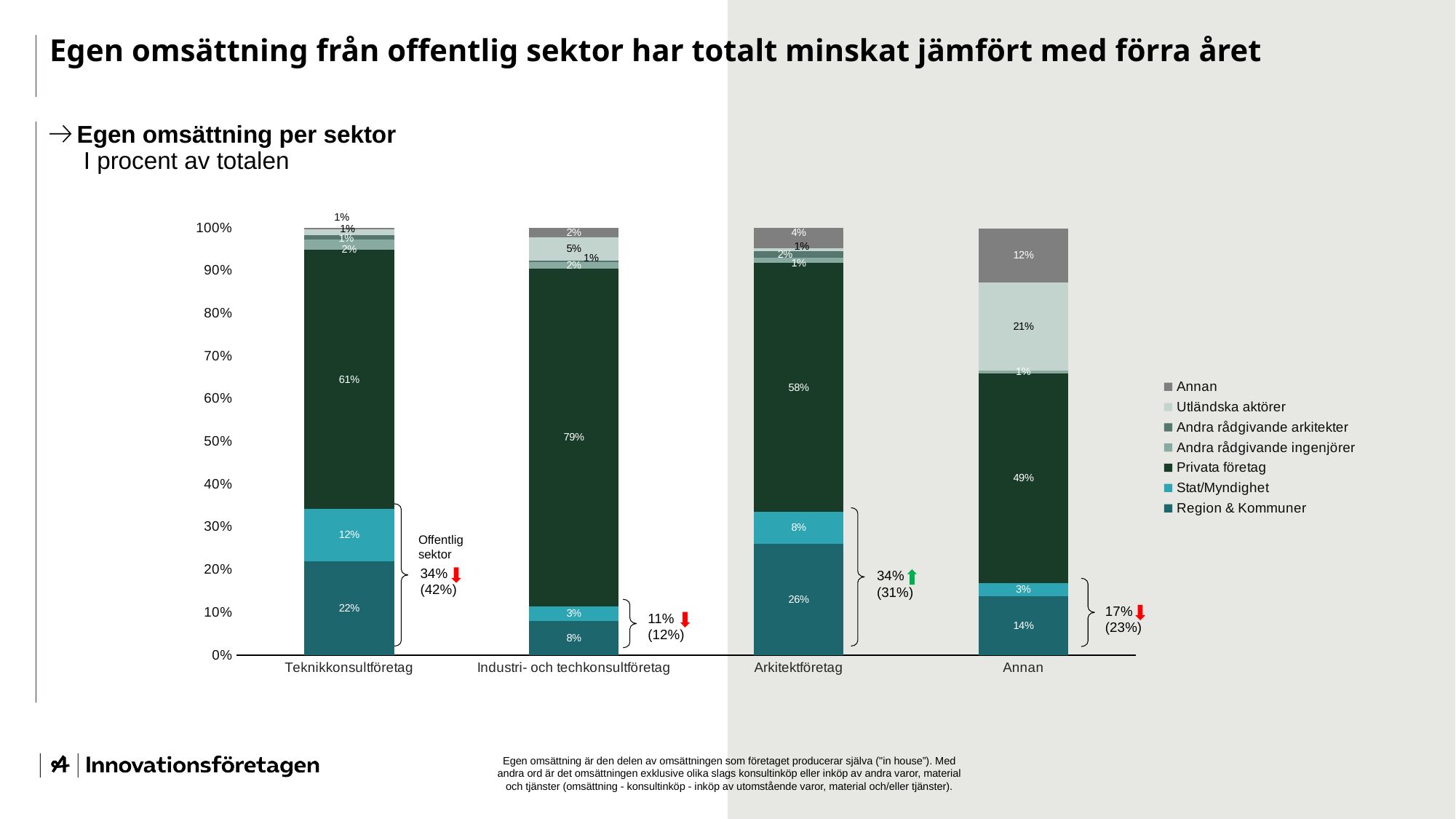
What is the Offentlig sektor share annotated for the Annan bar? 17% Which is larger: the Stat/Myndighet value for Arkitektföretag or for Annan? Arkitektföretag What is the value for Privata företag in the Industri- och techkonsultföretag bar? 79% Which category has the lowest value for Region & Kommuner? Industri- och techkonsultföretag What is the value for Stat/Myndighet in the Teknikkonsultföretag bar? 12% What is the value for Utländska aktörer in the Annan bar? 21% How many categories are shown on the x axis? 4 What is the difference between the Privata företag values for Teknikkonsultföretag and Arkitektföretag? 3% What type of chart is shown on the slide? Stacked bar chart Which category has the highest value for Privata företag? Industri- och techkonsultföretag What is the value for Region & Kommuner in the Arkitektföretag bar? 26% How many series does the legend list? 7